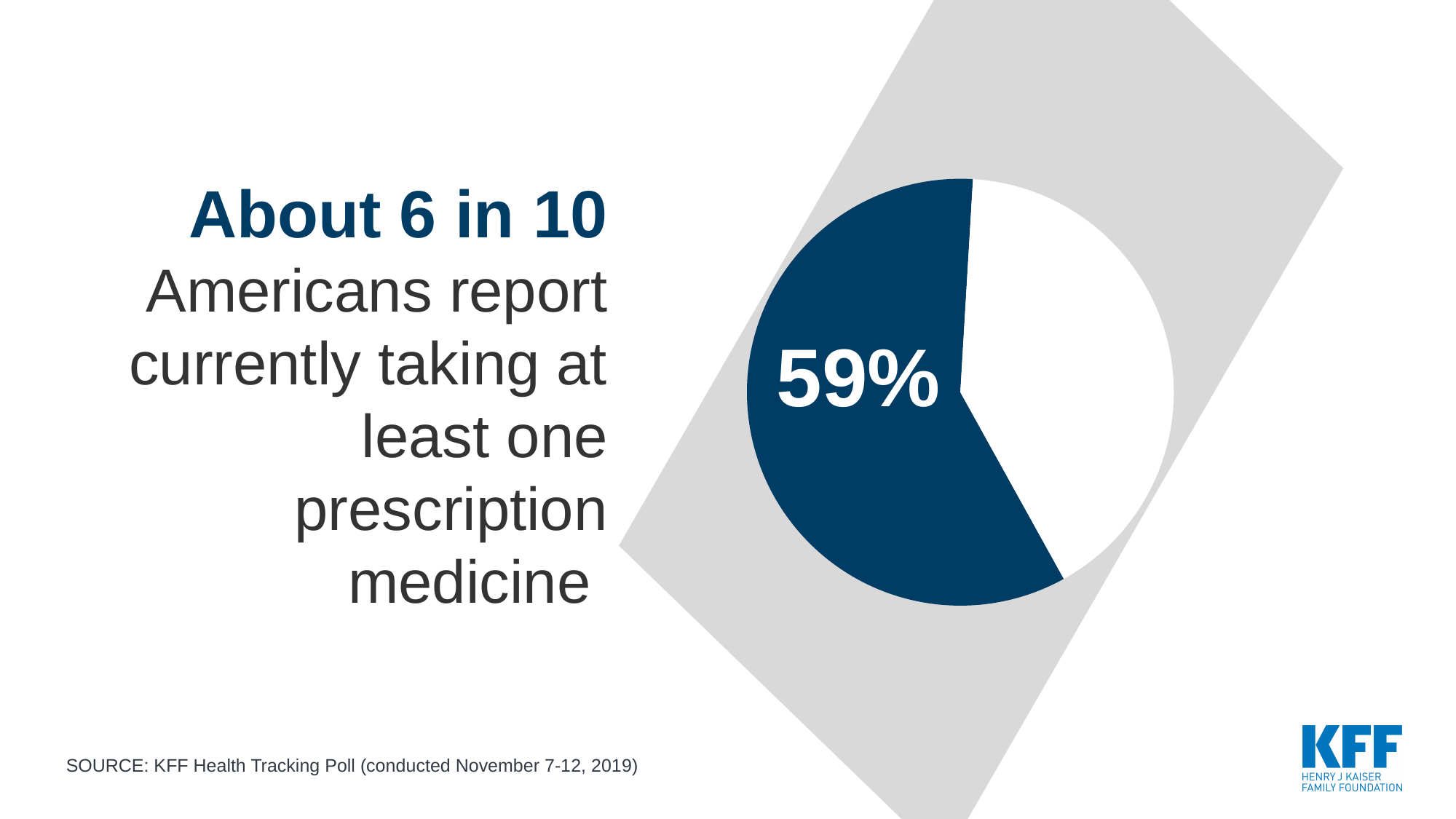
What share of the pie does the dark blue slice represent? 59% Which slice of the pie chart is the largest? the dark blue slice (59%) What colour is the slice labelled 59%? dark blue Is the value of the dark blue slice greater or less than 50%? greater What kind of chart is shown on the slide? pie chart According to the slide text, about how many in 10 Americans report currently taking at least one prescription medicine? About 6 in 10 How many slices does the pie chart have? 2 What percentage is printed on the dark blue slice of the pie chart? 59% Which slice of the pie chart is larger, the dark blue slice or the white slice? dark blue slice